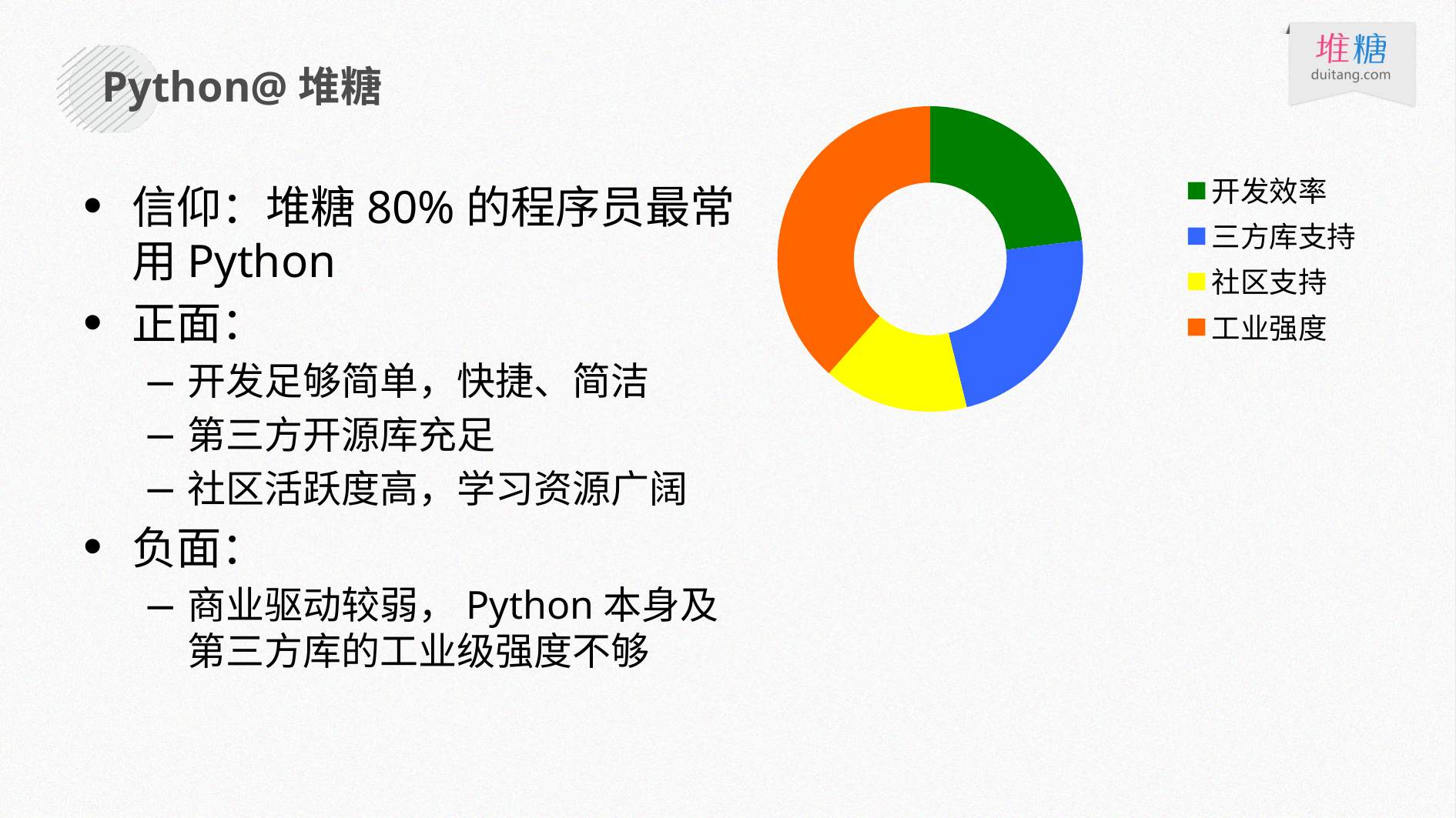
Which slice is larger, 工业强度 or 社区支持? 工业强度 What colour represents 开发效率 in the chart? green Which category is shown in orange in the chart? 工业强度 Which slice is larger, 开发效率 or 社区支持? 开发效率 Which category has the smallest slice in the chart? 社区支持 Which slice is larger, 工业强度 or 开发效率? 工业强度 Which category has the largest slice in the chart? 工业强度 How many categories does the chart's legend list? 4 What kind of chart is shown on the slide? doughnut (pie) chart